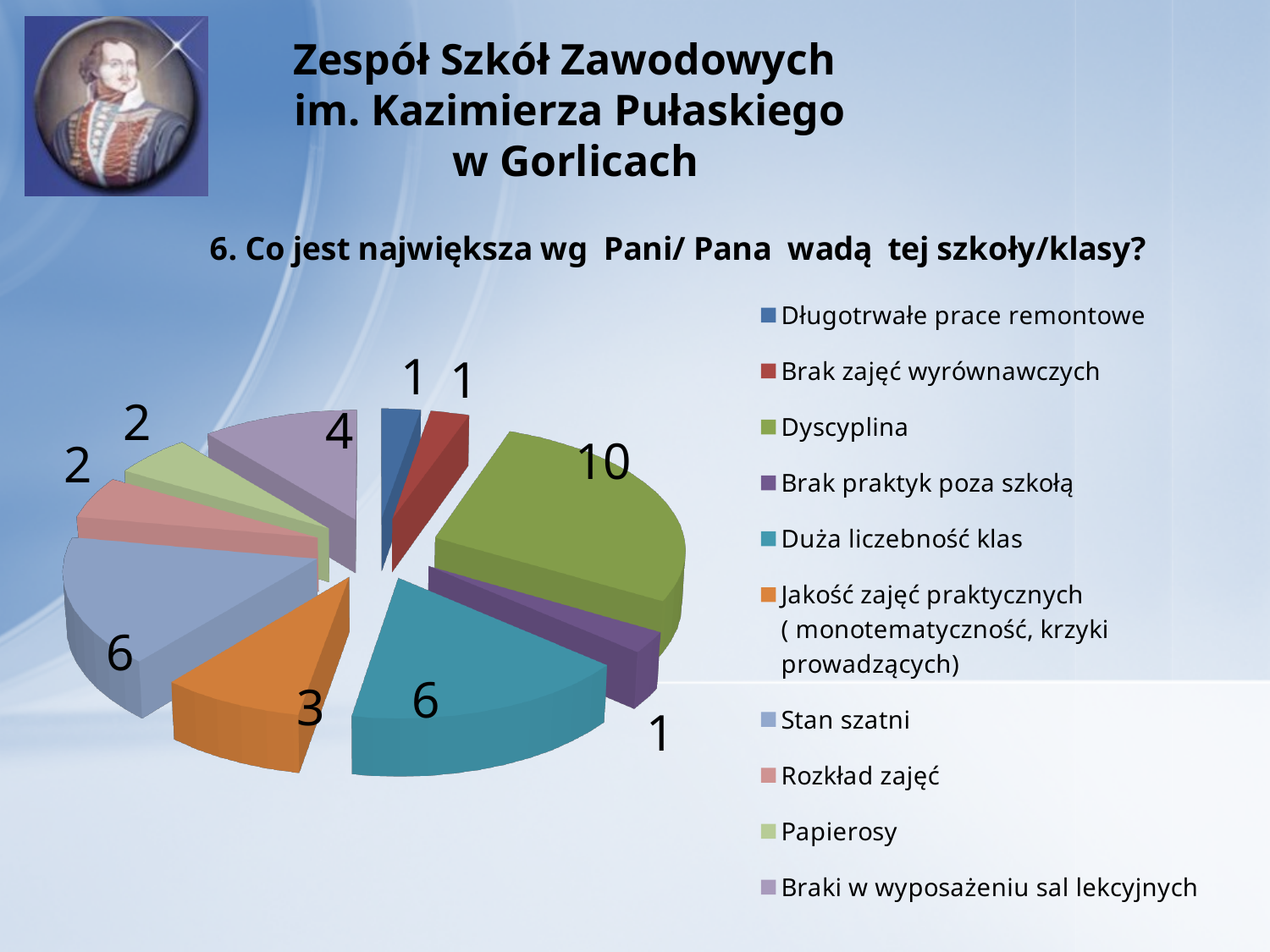
What is the title of the chart? 6. Co jest największa wg Pani/ Pana wadą tej szkoły/klasy? What kind of chart is shown on the slide? pie chart What is the difference between the values for Dyscyplina and Duża liczebność klas? 4 Which is larger, the value for Stan szatni or the value for Rozkład zajęć? Stan szatni What is the value for Papierosy? 2 What is the value for Braki w wyposażeniu sal lekcyjnych? 4 Which category has the highest value? Dyscyplina How many categories does the pie chart have? 10 What is the value for Jakość zajęć praktycznych? 3 What is the value for Dyscyplina? 10 What is the value for Stan szatni? 6 What is the total of all the values in the pie chart? 36